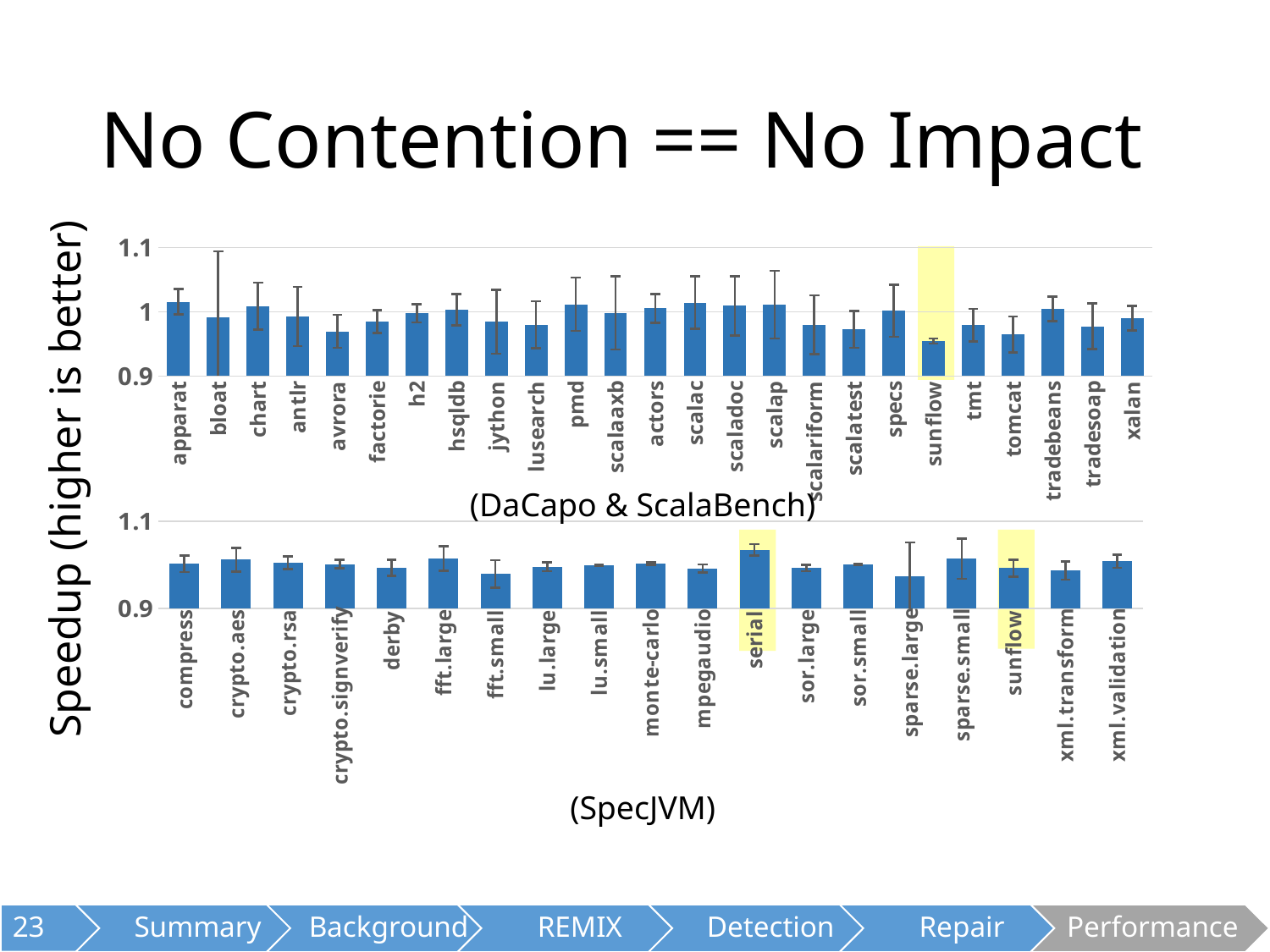
In the (DaCapo & ScalaBench) chart, is the value for avrora greater or less than 1? less In the (SpecJVM) chart, is the value for serial greater or less than 0.9? greater In the (DaCapo & ScalaBench) chart, is the value for sunflow greater or less than 1? less How many benchmark categories are shown in the (SpecJVM) chart? 19 In the (SpecJVM) chart, which is larger, the value for serial or the value for fft.small? serial How many benchmark categories are shown in the (DaCapo & ScalaBench) chart? 25 In the (DaCapo & ScalaBench) chart, which is larger, the value for apparat or the value for sunflow? apparat What kind of chart is the (DaCapo & ScalaBench) chart? bar chart What is the label on the vertical axis shared by the two charts? Speedup (higher is better) In the (SpecJVM) chart, which benchmark has the highest speedup? serial